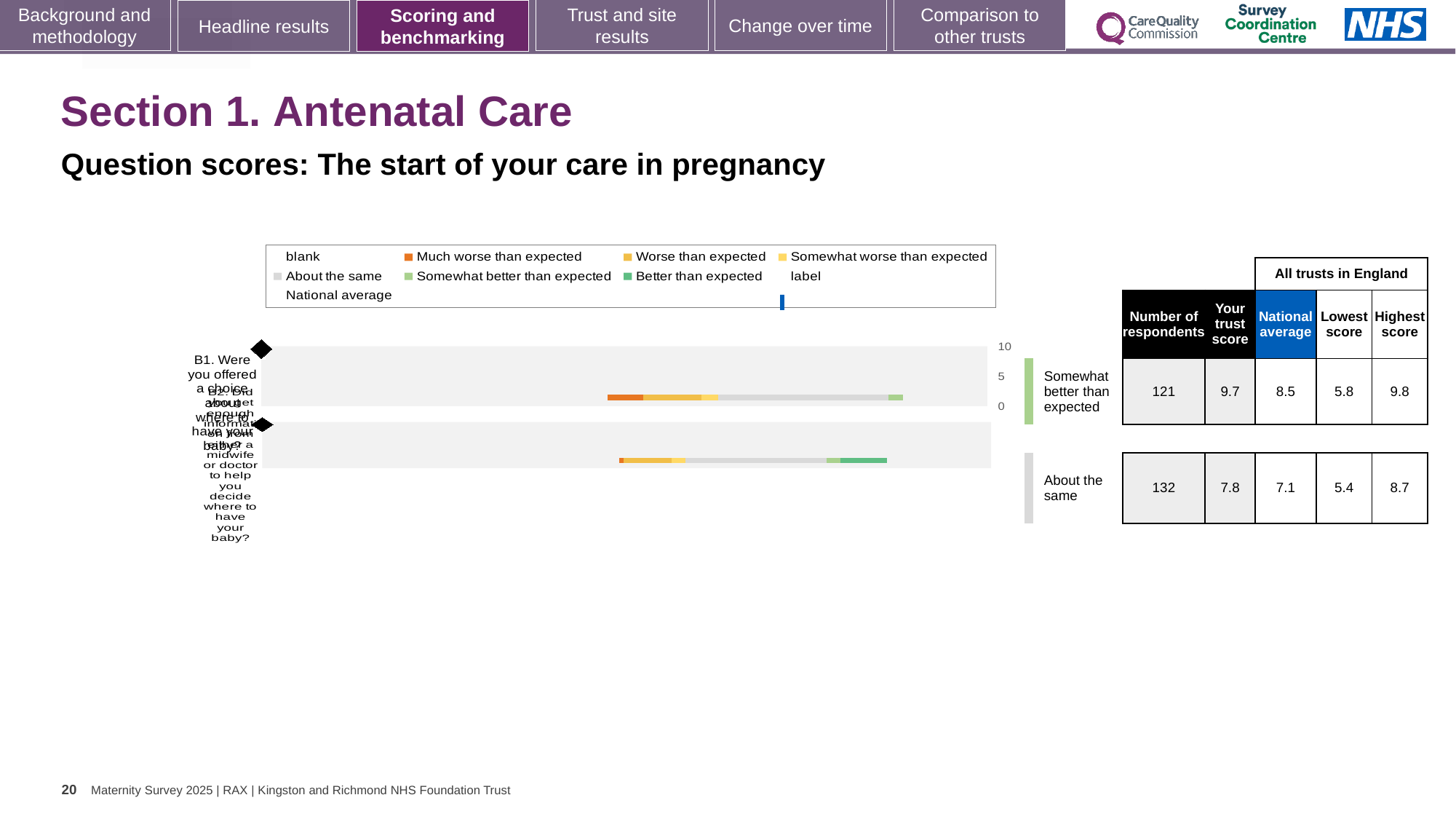
By how much does the trust score for B1 exceed the national average for B1? 1.2 Which question has the higher trust score, B1 or B2? B1 How many questions (categories) are plotted in the chart? 2 What kind of chart is used to show the question scores for B1 and B2? bar chart Which benchmark category is shown for question B1? Somewhat better than expected How many more respondents answered B2 than B1? 11 How many respondents answered question B1? 121 What is the trust score for B1 (Were you offered a choice about where to have your baby?)? 9.7 What is the lowest score among all trusts in England for B1? 5.8 What colour does the legend use for 'Much worse than expected'? orange What is the national average score for B2 (Did you get enough information from either a midwife or doctor to help you decide where to have your baby?)? 7.1 What is the highest score among all trusts in England for B2? 8.7